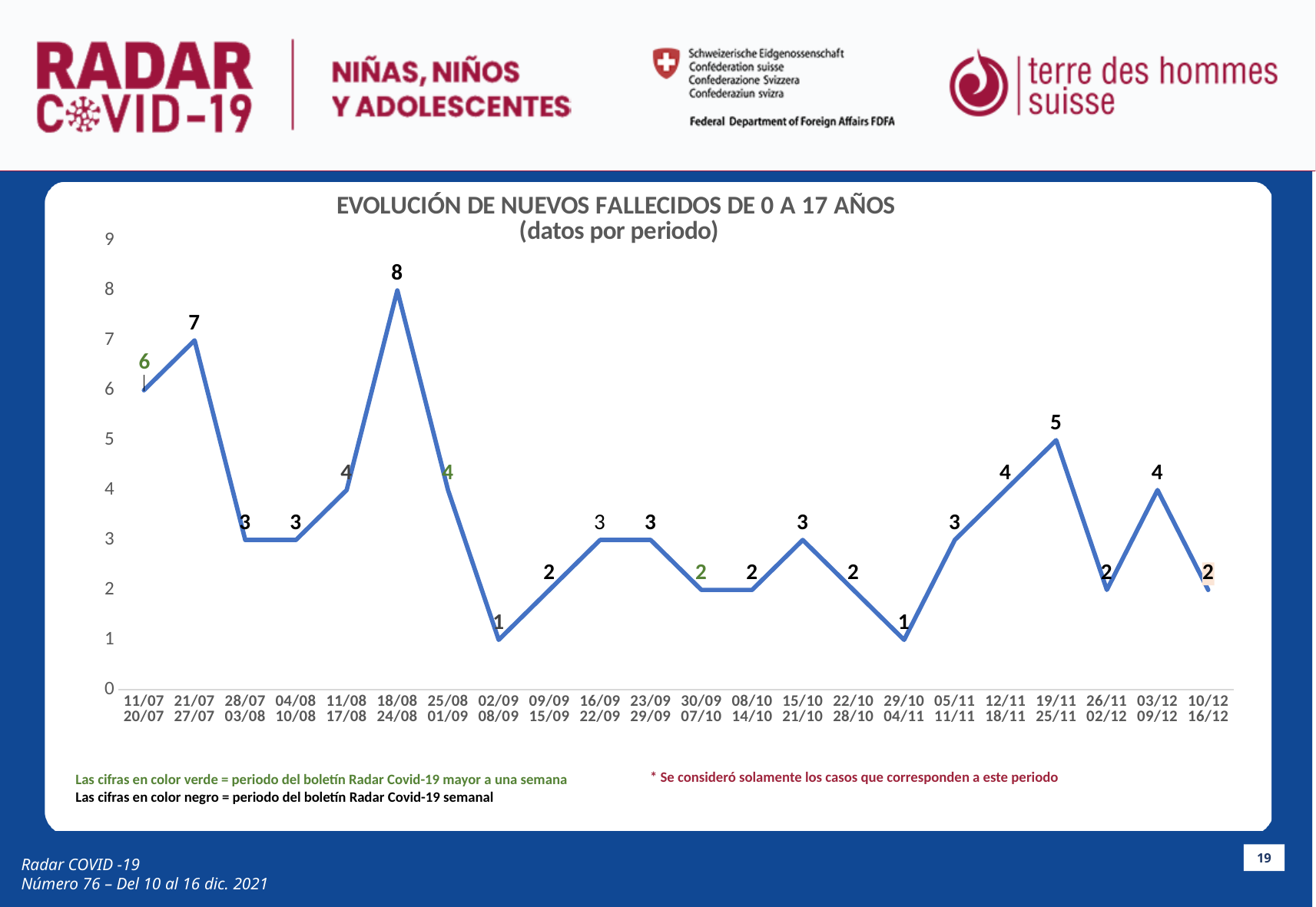
What is the lowest value plotted on the chart? 1 How many periods are plotted on the x axis? 22 What is the value for the period 21/07–27/07? 7 What is the difference between the values for 18/08–24/08 and 25/08–01/09? 4 What is the value for the period 19/11–25/11? 5 Does the value rise or fall from 19/11–25/11 to 26/11–02/12? fall What is the value for the last period, 10/12–16/12? 2 What is the value for the period 18/08–24/08? 8 Which period has the highest value? 18/08–24/08 What is the title of the chart? EVOLUCIÓN DE NUEVOS FALLECIDOS DE 0 A 17 AÑOS (datos por periodo) Which is larger, the value for 03/12–09/12 or the value for 26/11–02/12? 03/12–09/12 What type of chart is shown on the slide? line chart